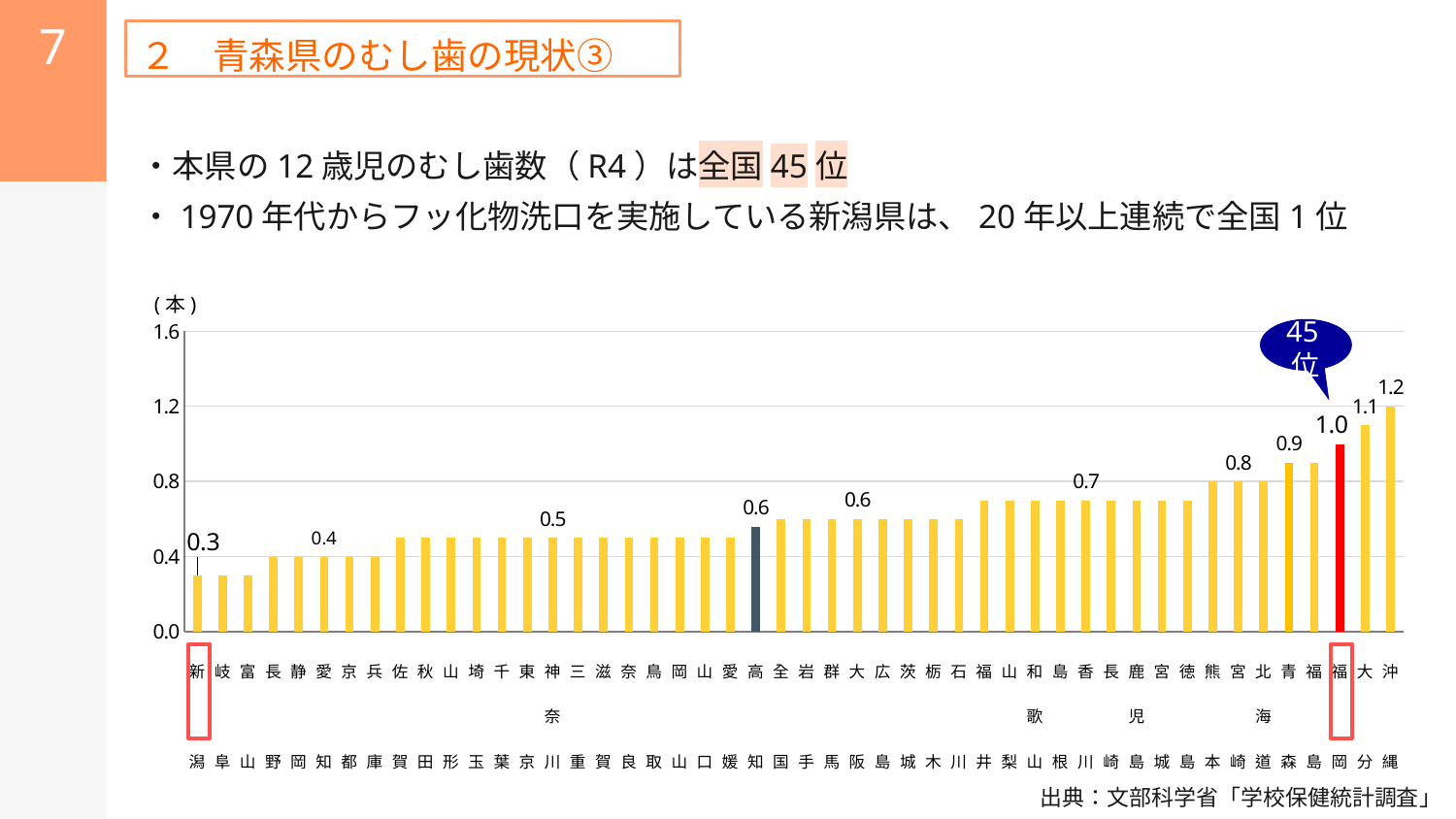
What is the value shown for 大分 in the chart? 1.1 What is the value shown for 沖縄 in the chart? 1.2 What unit is shown at the top of the y axis? (本) What is the value shown for 新潟 in the chart? 0.3 Is the value for 高知 greater or less than 0.8? less What is the value labelled above the 青森 bar? 0.9 Do the values generally rise or fall from left to right along the x axis? rise Which prefecture has the highest value in the chart? 沖縄 What kind of chart is shown on the slide? bar chart What value is labelled on the red-highlighted bar with the 45位 callout? 1.0 What is the difference between the values for 沖縄 and 新潟? 0.9 Which has the larger value, 大分 or 新潟? 大分